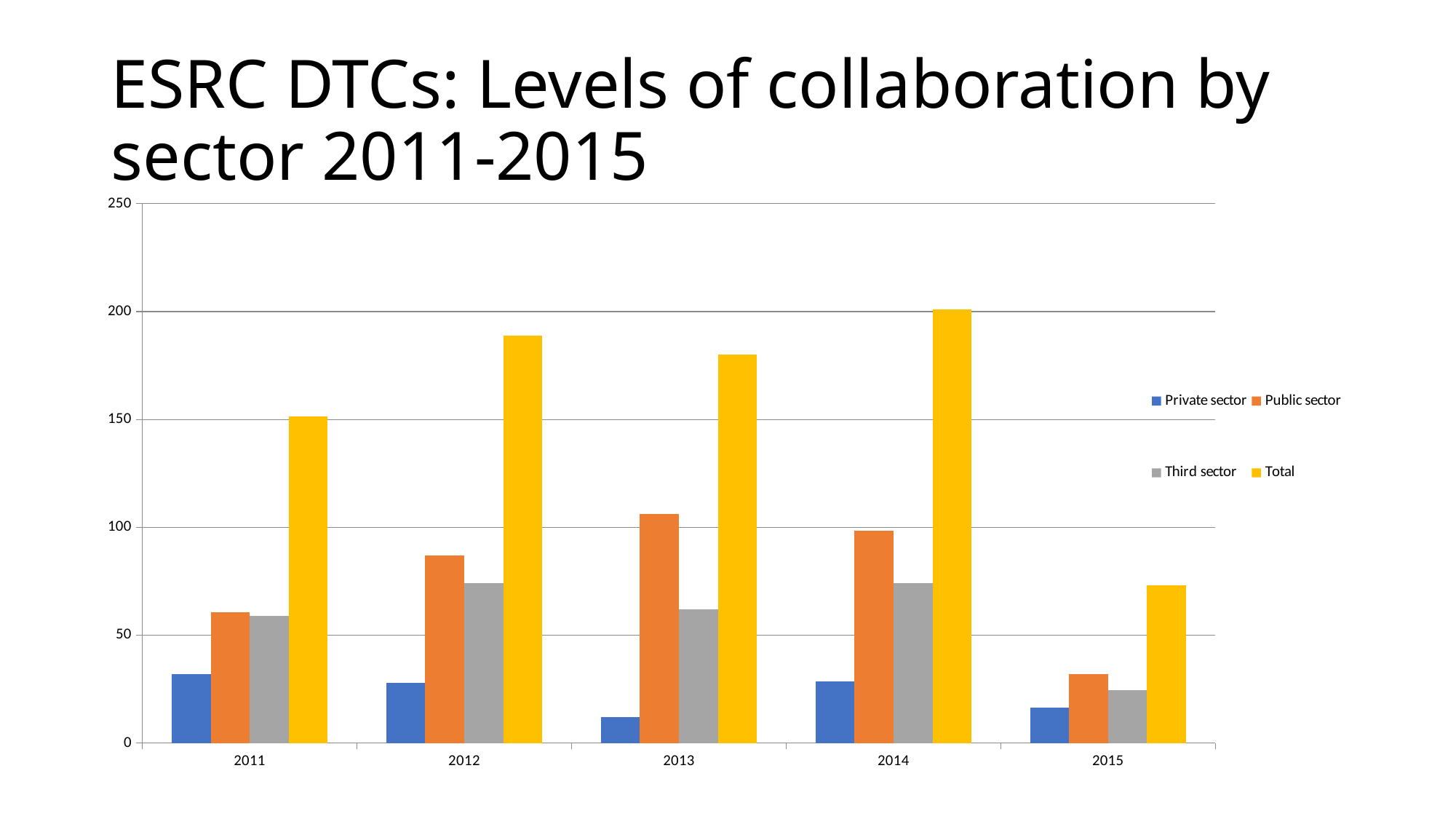
How many years are shown on the x axis? 5 In which year is the Total bar highest? 2014 Does the Total value rise or fall from 2014 to 2015? Fall What kind of chart is shown on the slide? Bar chart Which is larger: the Public sector value for 2013 or the Public sector value for 2015? 2013 In which year is the Public sector bar highest? 2013 Is the Public sector value for 2013 greater or less than 100? greater In which year is the Total bar lowest? 2015 Is the Total value for 2015 greater or less than 100? less How many series does the legend list? 4 In which year is the Private sector bar lowest? 2013 Is the Total value for 2012 greater or less than 200? less